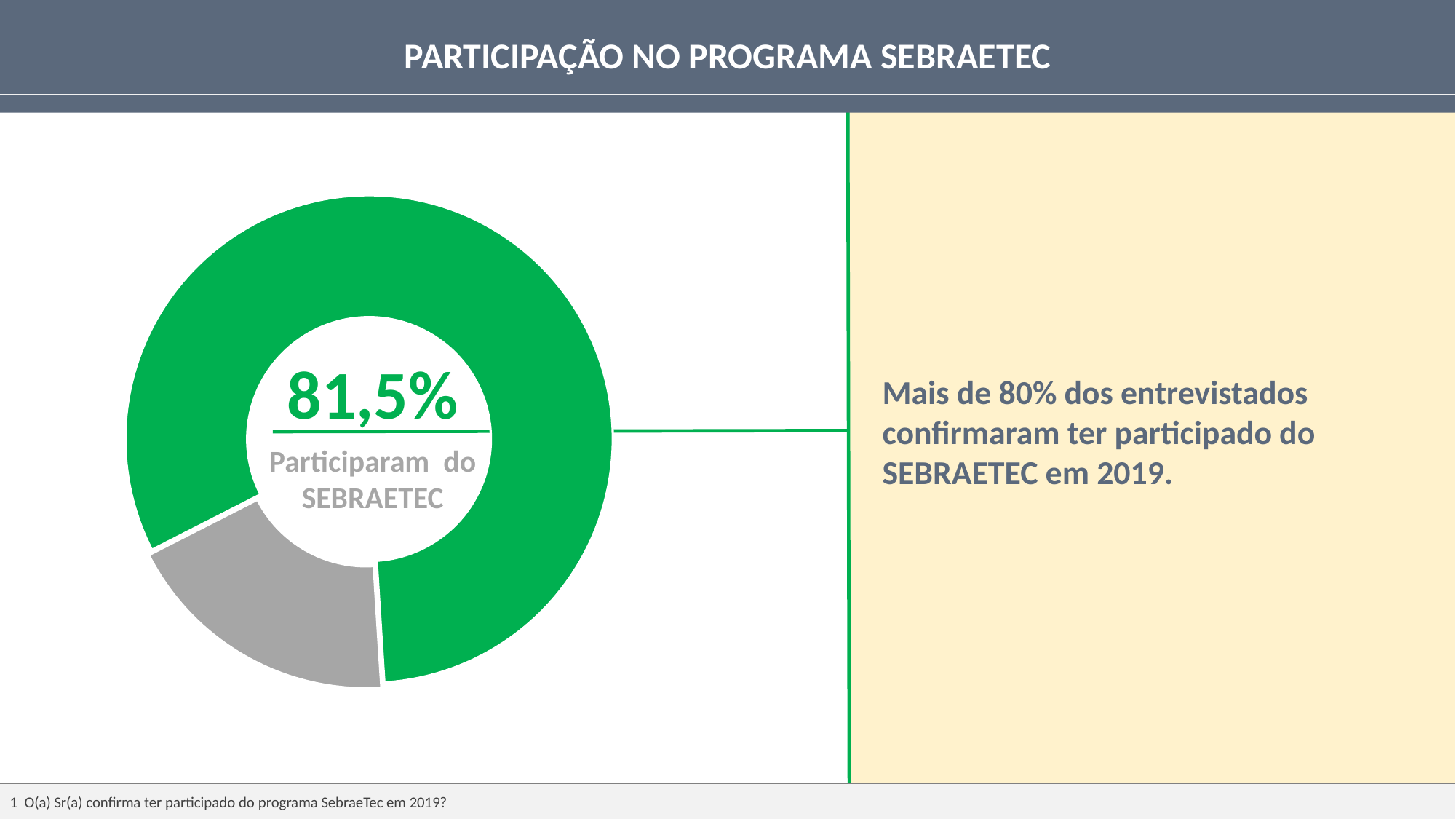
What colour is the slice representing those who participated in SEBRAETEC? green What kind of chart is shown on the slide? pie chart (donut) What percentage is printed in the centre of the chart? 81,5% Is the value for the grey slice greater or less than 50%? less How many slices does the chart have? 2 What label appears below the percentage in the centre of the chart? Participaram do SEBRAETEC What is the title of the slide containing the chart? PARTICIPAÇÃO NO PROGRAMA SEBRAETEC Which slice is larger, the green one or the grey one? green Which category represents the largest slice of the chart? Participaram do SEBRAETEC What share of respondents participated in SEBRAETEC according to the chart? 81,5% Is the value for the green slice greater or less than 50%? greater